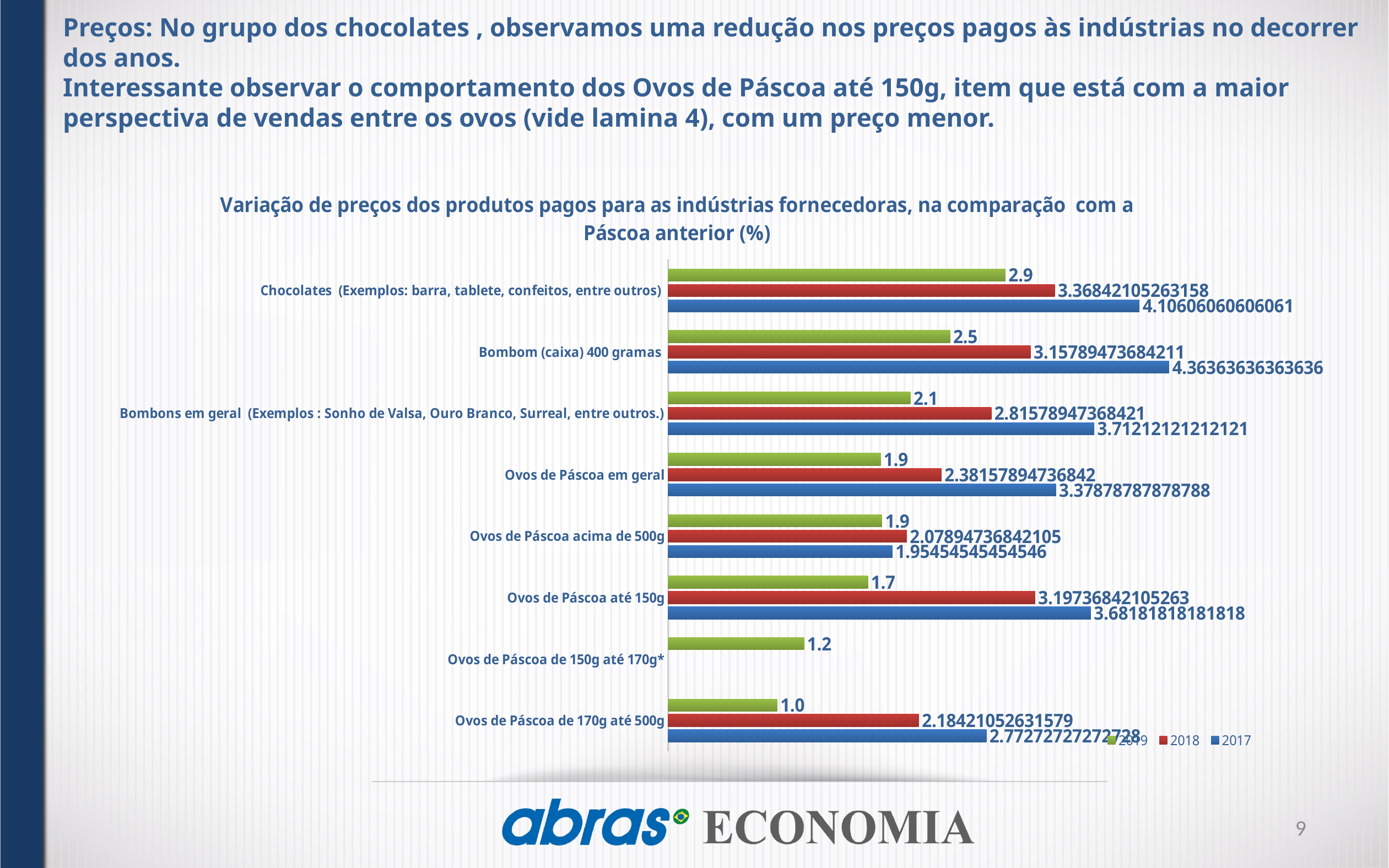
What is the 2019 value for Ovos de Páscoa de 150g até 170g*? 1.2 Which category has the highest 2019 value? Chocolates (Exemplos: barra, tablete, confeitos, entre outros) What is the 2017 value for Bombom (caixa) 400 gramas? 4.36363636363636 How many product categories are shown in the chart? 8 What is the 2018 value for Ovos de Páscoa até 150g? 3.19736842105263 Which category has the highest 2017 value? Bombom (caixa) 400 gramas How many series does the legend list? 3 What is the difference between the 2019 values for Chocolates and Bombom (caixa) 400 gramas? 0.4 For Ovos de Páscoa até 150g, which is larger: the 2018 value or the 2019 value? 2018 What kind of chart is shown on the slide? Bar chart What is the 2019 value for Chocolates (Exemplos: barra, tablete, confeitos, entre outros)? 2.9 Which category has the lowest 2019 value? Ovos de Páscoa de 170g até 500g